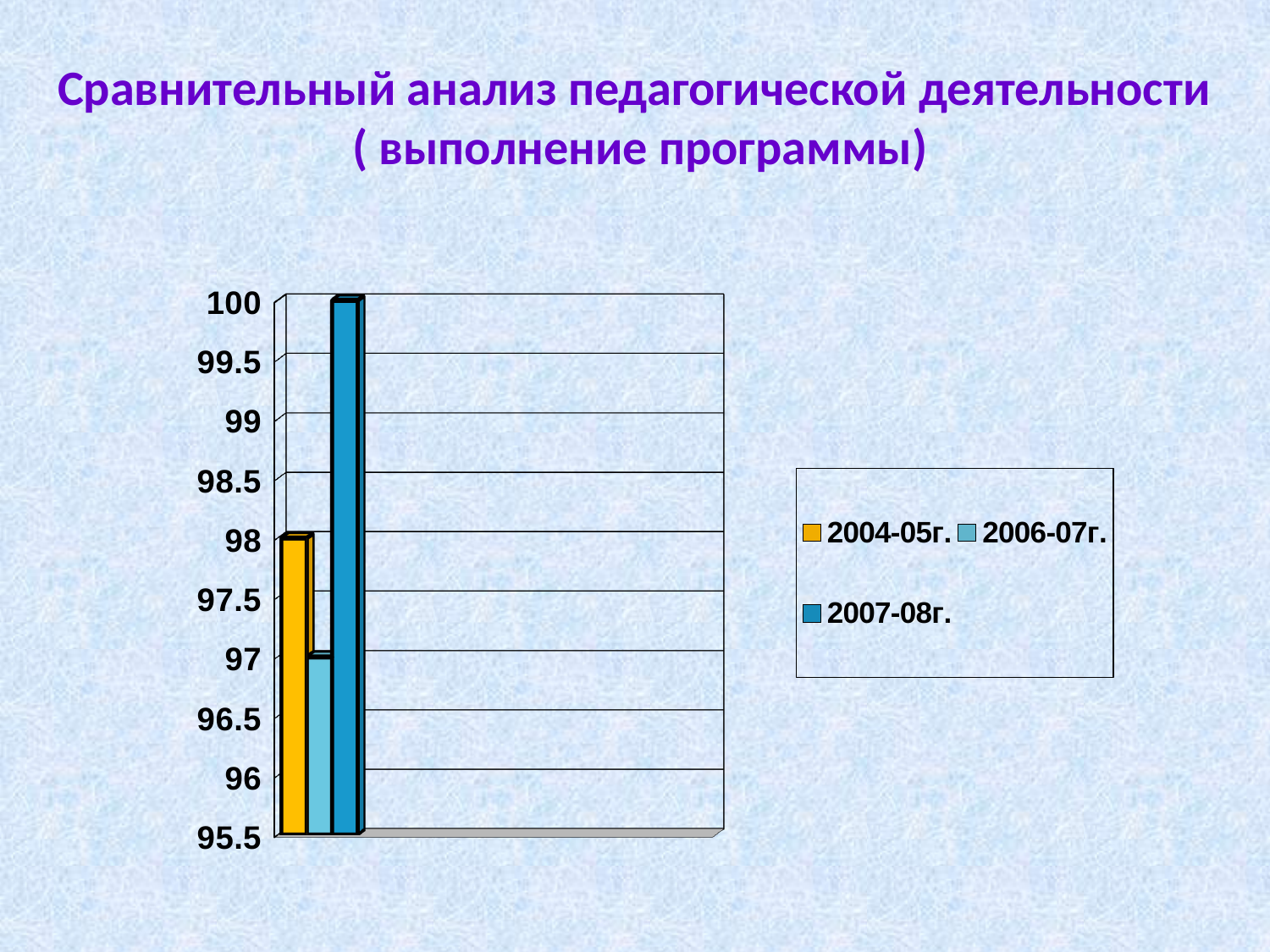
Is the bar for 2004-05г. taller or shorter than the bar for 2006-07г.? taller What kind of chart is shown on the slide? bar chart Is the value for 2007-08г. greater or less than 99? greater Which series has the highest bar? 2007-08г. What colour is the bar for 2004-05г. in the legend? orange Which series has the lowest bar? 2006-07г. Is the value for 2006-07г. greater or less than 97.5? less How many series does the legend list? 3 What value does the bar for 2004-05г. reach on the axis? 98 Is the bar for 2007-08г. taller or shorter than the bar for 2004-05г.? taller What value does the bar for 2007-08г. reach on the axis? 100 Is the value for 2004-05г. greater or less than 97? greater